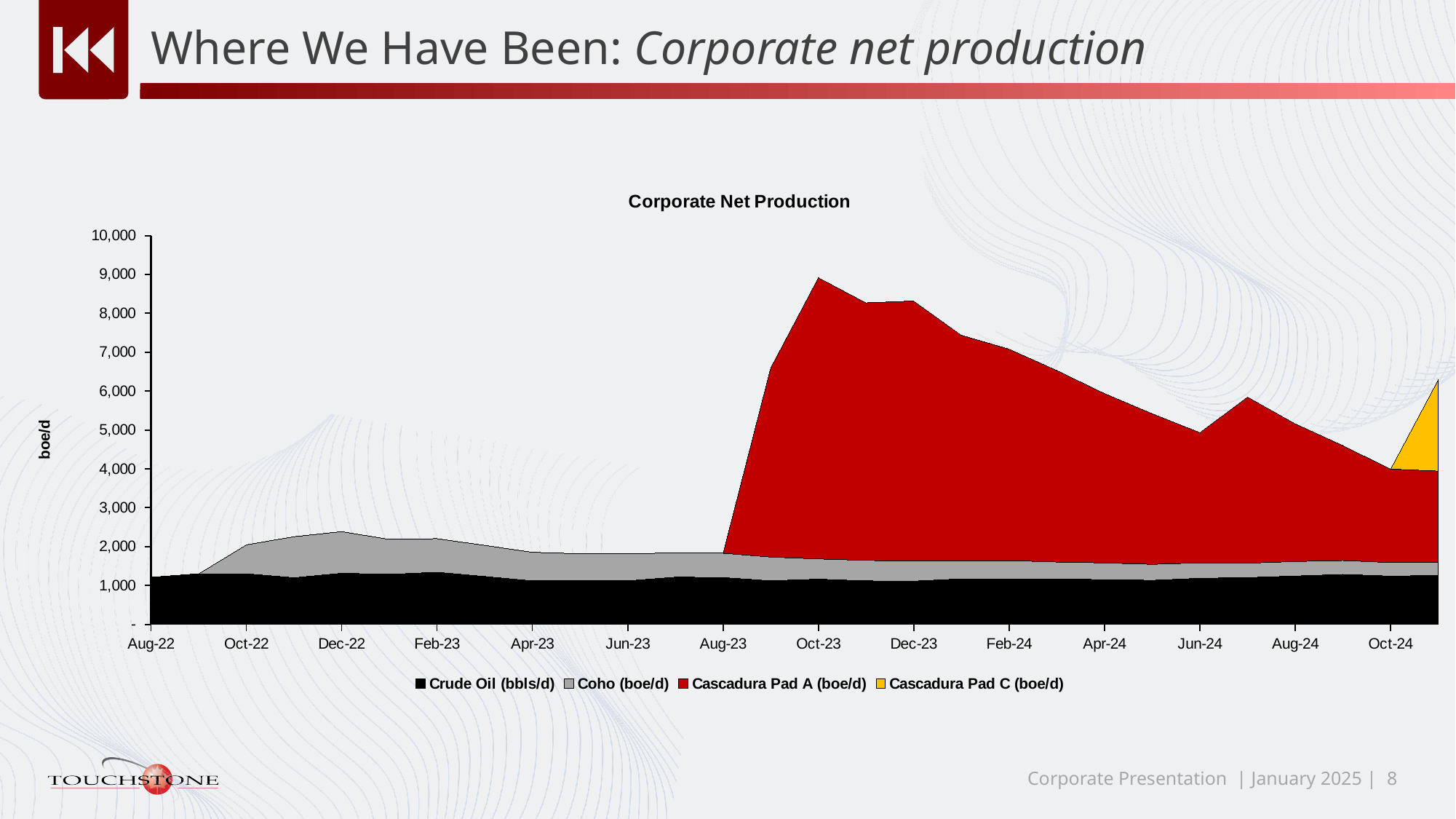
Which is larger, total production at Oct-23 or total production at Oct-24? Oct-23 Is the total corporate net production at Oct-24 greater or less than 5,000 boe/d? less Which series only appears at the very end of the chart, around Oct-24? Cascadura Pad C (boe/d) Is the total corporate net production at Oct-23 greater or less than 8,000 boe/d? greater How many series does the legend list? 4 Is the total corporate net production at Aug-22 greater or less than 2,000 boe/d? less Does Cascadura Pad A production rise or fall between Oct-23 and Jun-24? Fall What is the title of the chart? Corporate Net Production How many month labels are shown along the x axis? 14 What is the label on the vertical axis? boe/d What kind of chart is shown on the slide? Area chart Around which month does total corporate net production reach its highest point? Oct-23